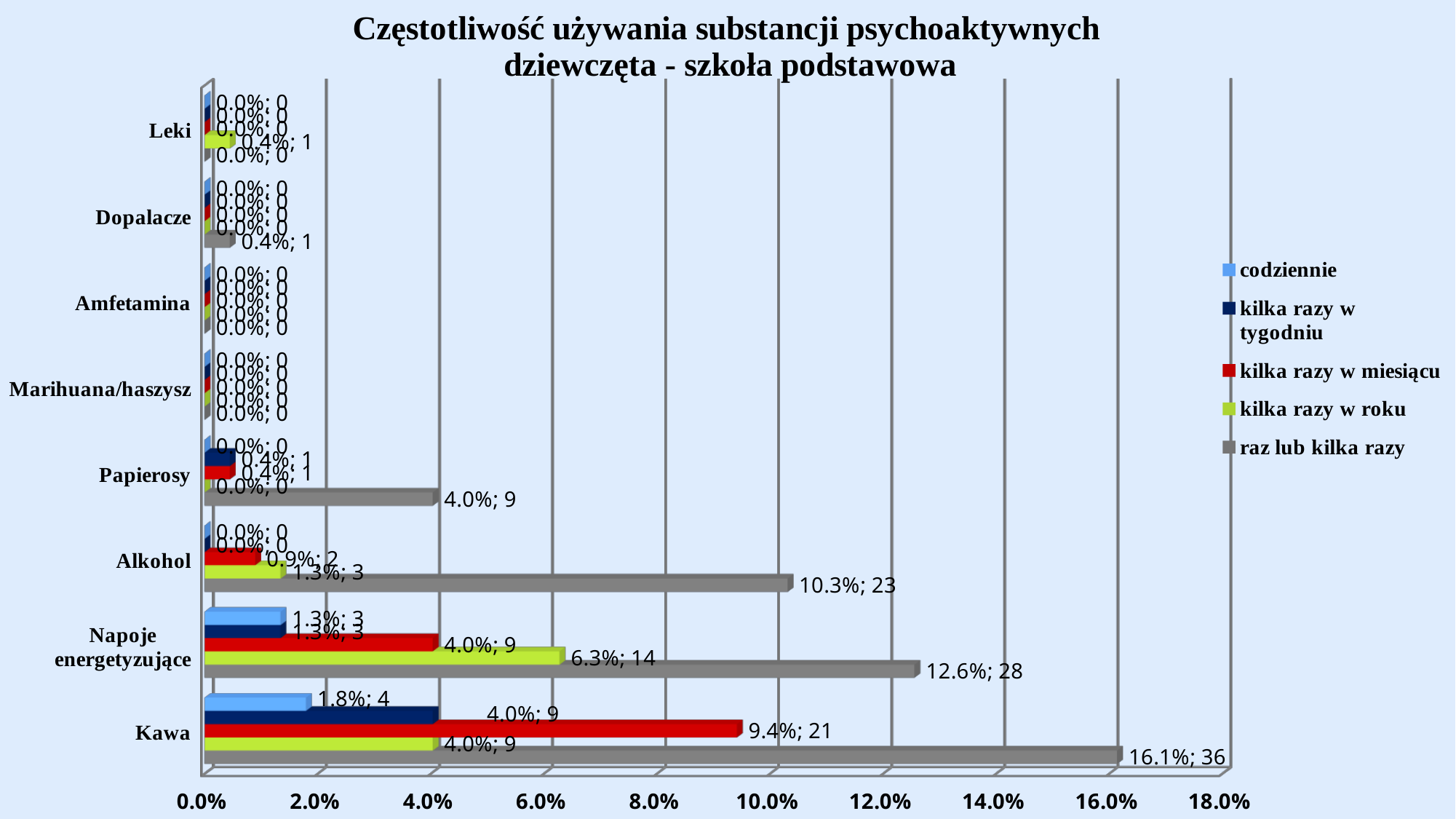
What type of chart is shown on the slide? bar chart Is the 'raz lub kilka razy' value for Papierosy greater or less than 6.0%? less Which is larger: the 'kilka razy w miesiącu' value for Kawa or for Napoje energetyzujące? Kawa What is the value for Alkohol in the 'raz lub kilka razy' series? 10.3%; 23 What is the value for Kawa in the 'raz lub kilka razy' series? 16.1%; 36 Which category has the highest value in the 'raz lub kilka razy' series? Kawa What is the value for Napoje energetyzujące in the 'kilka razy w roku' series? 6.3%; 14 What is the difference in percentage between Kawa and Napoje energetyzujące in the 'raz lub kilka razy' series? 3.5% How many substance categories are shown on the y axis? 8 What is the value for Kawa in the 'kilka razy w miesiącu' series? 9.4%; 21 What is the title of the chart? Częstotliwość używania substancji psychoaktywnych dziewczęta - szkoła podstawowa How many series does the legend list? 5